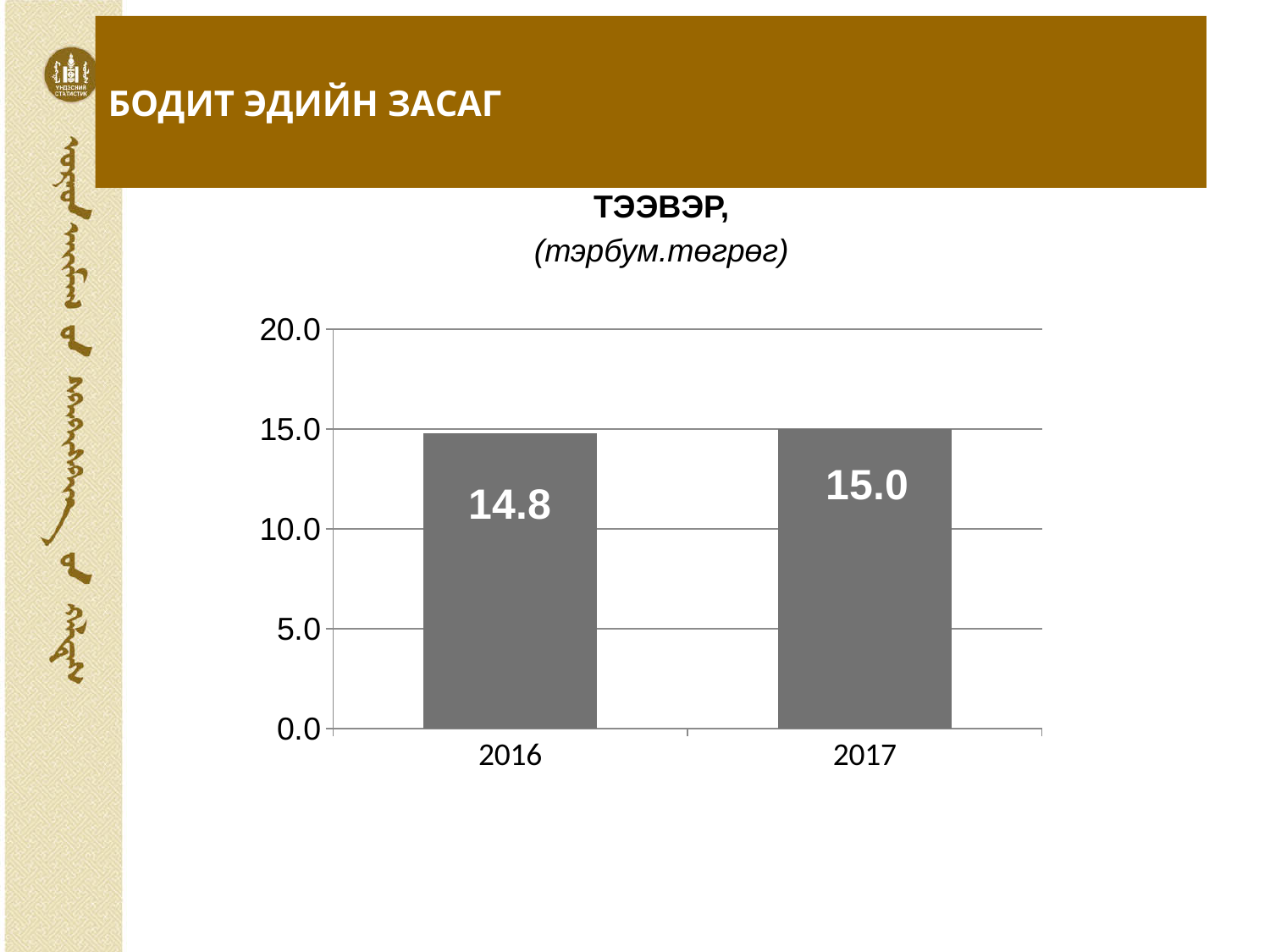
How many years are shown on the chart? 2 Is the value for 2017 greater or less than 20.0? less Which year has the higher value? 2017 What is the highest value shown on the y axis? 20.0 Which year has the lower value? 2016 What is the value for 2016? 14.8 Is the value for 2016 greater or less than 10.0? greater What is the value for 2017? 15.0 Do the values rise or fall from 2016 to 2017? rise What is the difference between the 2017 and 2016 values? 0.2 What kind of chart is shown on the slide? bar chart What is the title of the chart? ТЭЭВЭР, (тэрбум.төгрөг)